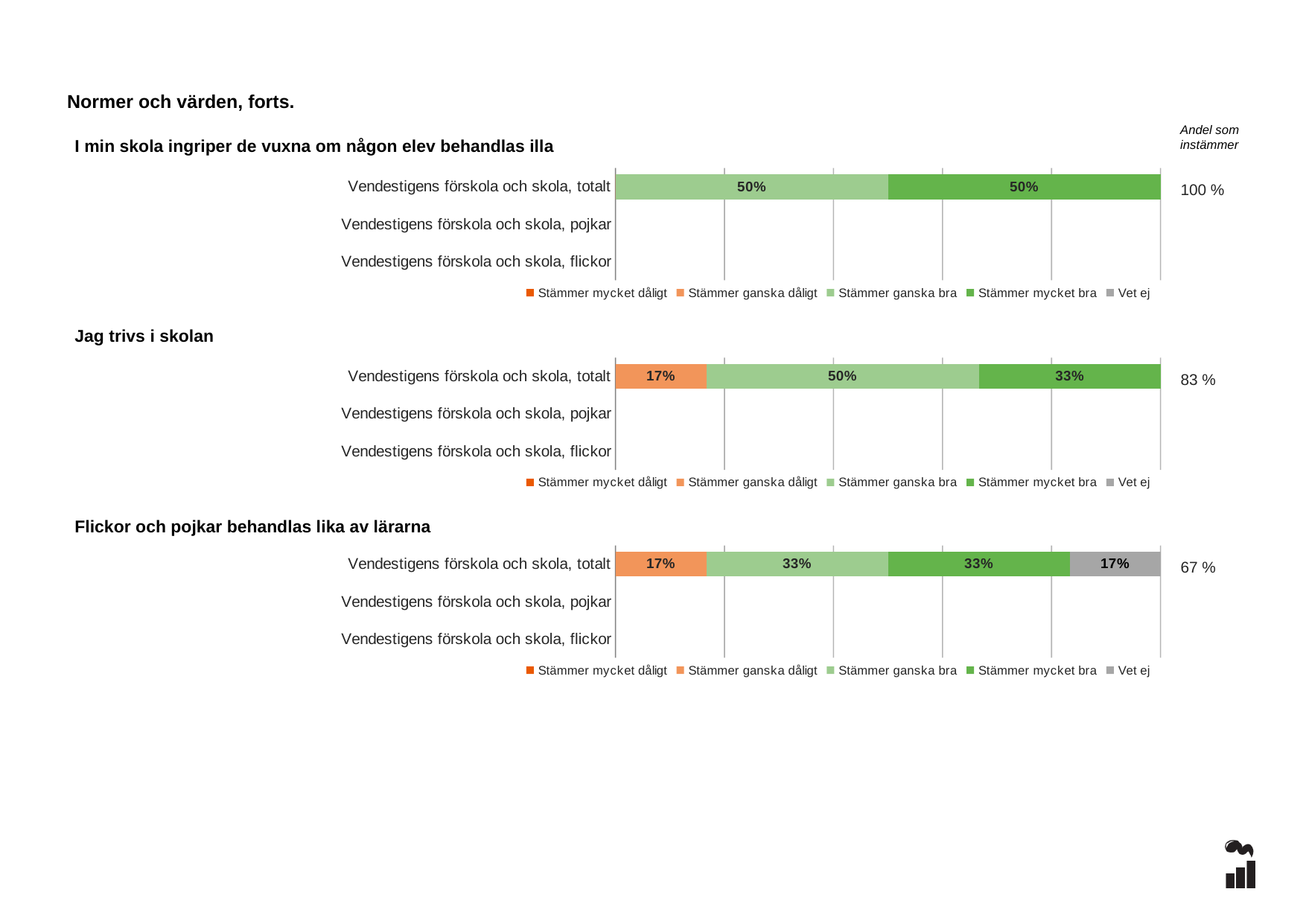
How many categories are shown on the y axis of the chart 'I min skola ingriper de vuxna om någon elev behandlas illa'? 3 In the chart 'I min skola ingriper de vuxna om någon elev behandlas illa', which categories have no bar plotted? Vendestigens förskola och skola, pojkar and Vendestigens förskola och skola, flickor In the chart 'I min skola ingriper de vuxna om någon elev behandlas illa', what is the value for 'Stämmer mycket bra' for 'Vendestigens förskola och skola, totalt'? 50% In the chart 'Jag trivs i skolan', what is the difference between 'Stämmer ganska bra' and 'Stämmer mycket bra' for 'Vendestigens förskola och skola, totalt'? 17 percentage points In the chart 'Jag trivs i skolan', which response has the largest share for 'Vendestigens förskola och skola, totalt'? Stämmer ganska bra How many series does the legend of the chart 'Jag trivs i skolan' list? 5 In the chart 'Jag trivs i skolan', what is the value for 'Stämmer ganska bra' for 'Vendestigens förskola och skola, totalt'? 50% What kind of chart is 'Flickor och pojkar behandlas lika av lärarna'? Stacked bar chart In the chart 'Jag trivs i skolan', what is the 'Andel som instämmer' shown to the right of the totalt bar? 83 % In the chart 'Flickor och pojkar behandlas lika av lärarna', what is the 'Andel som instämmer' shown to the right of the totalt bar? 67 % In the chart 'Flickor och pojkar behandlas lika av lärarna', what is the value for 'Vet ej' for 'Vendestigens förskola och skola, totalt'? 17% In the chart 'Flickor och pojkar behandlas lika av lärarna', which is larger for 'Vendestigens förskola och skola, totalt': 'Stämmer ganska dåligt' or 'Stämmer ganska bra'? Stämmer ganska bra